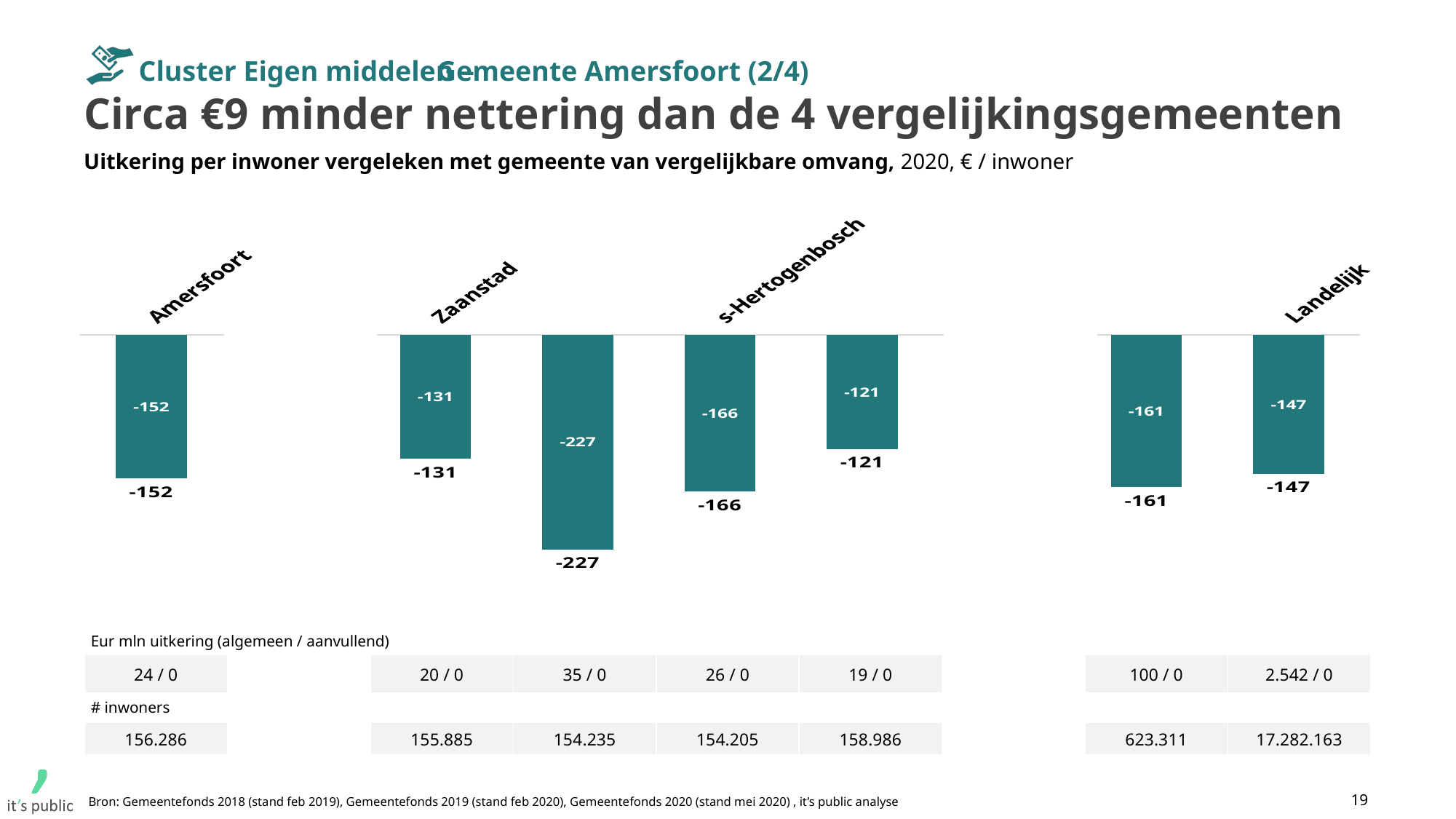
What kind of chart is shown on the slide? bar chart What is the value for Zaanstad? -131 How many bars are plotted in the chart? 7 Which has the larger (less negative) value, s-Hertogenbosch or Landelijk? Landelijk What is the highest (least negative) value shown in the chart? -121 What is the difference between the values for Amersfoort and Landelijk? 5 What is the value for Landelijk? -147 In what unit are the chart values expressed, according to the subtitle? € / inwoner What is the value for s-Hertogenbosch? -166 What is the value for Amersfoort? -152 Which has the larger (less negative) value, Amersfoort or Zaanstad? Zaanstad What is the lowest (most negative) value shown in the chart? -227